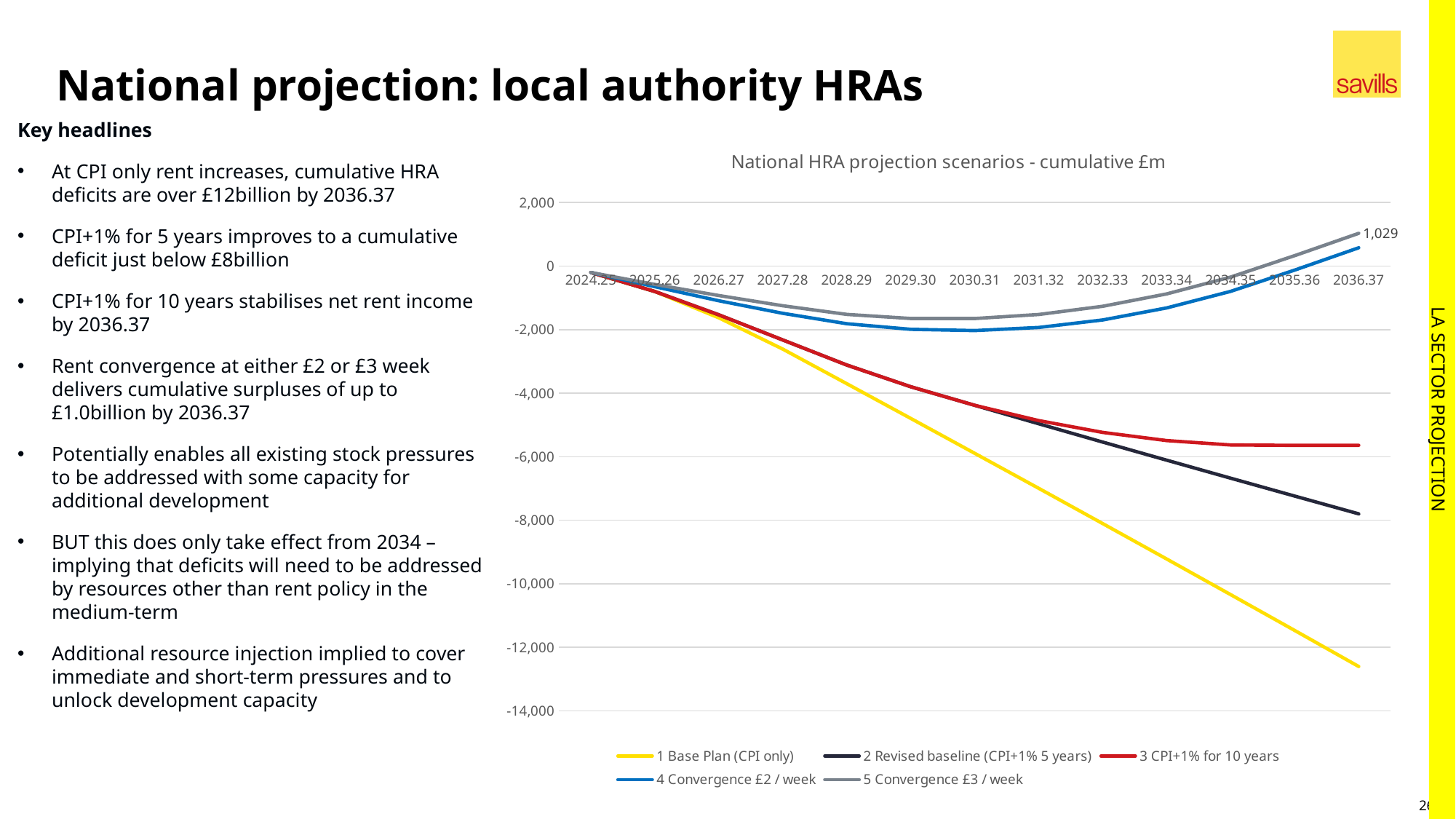
Which series has the highest value in 2036.37? 5 Convergence £3 / week How many years are shown on the x axis? 13 What kind of chart is shown on the slide? line chart What is the title of the chart? National HRA projection scenarios - cumulative £m In 2036.37, which is larger: 4 Convergence £2 / week or 3 CPI+1% for 10 years? 4 Convergence £2 / week Is the value for 1 Base Plan (CPI only) in 2036.37 greater or less than -10,000? less Is the value for 2 Revised baseline (CPI+1% 5 years) in 2036.37 greater or less than -6,000? less Which series has the lowest value in 2036.37? 1 Base Plan (CPI only) Does the 1 Base Plan (CPI only) line rise or fall from 2024.25 to 2036.37? fall What is the value for 5 Convergence £3 / week in 2036.37? 1,029 Is the value for 4 Convergence £2 / week in 2036.37 greater or less than 0? greater How many series does the chart legend list? 5